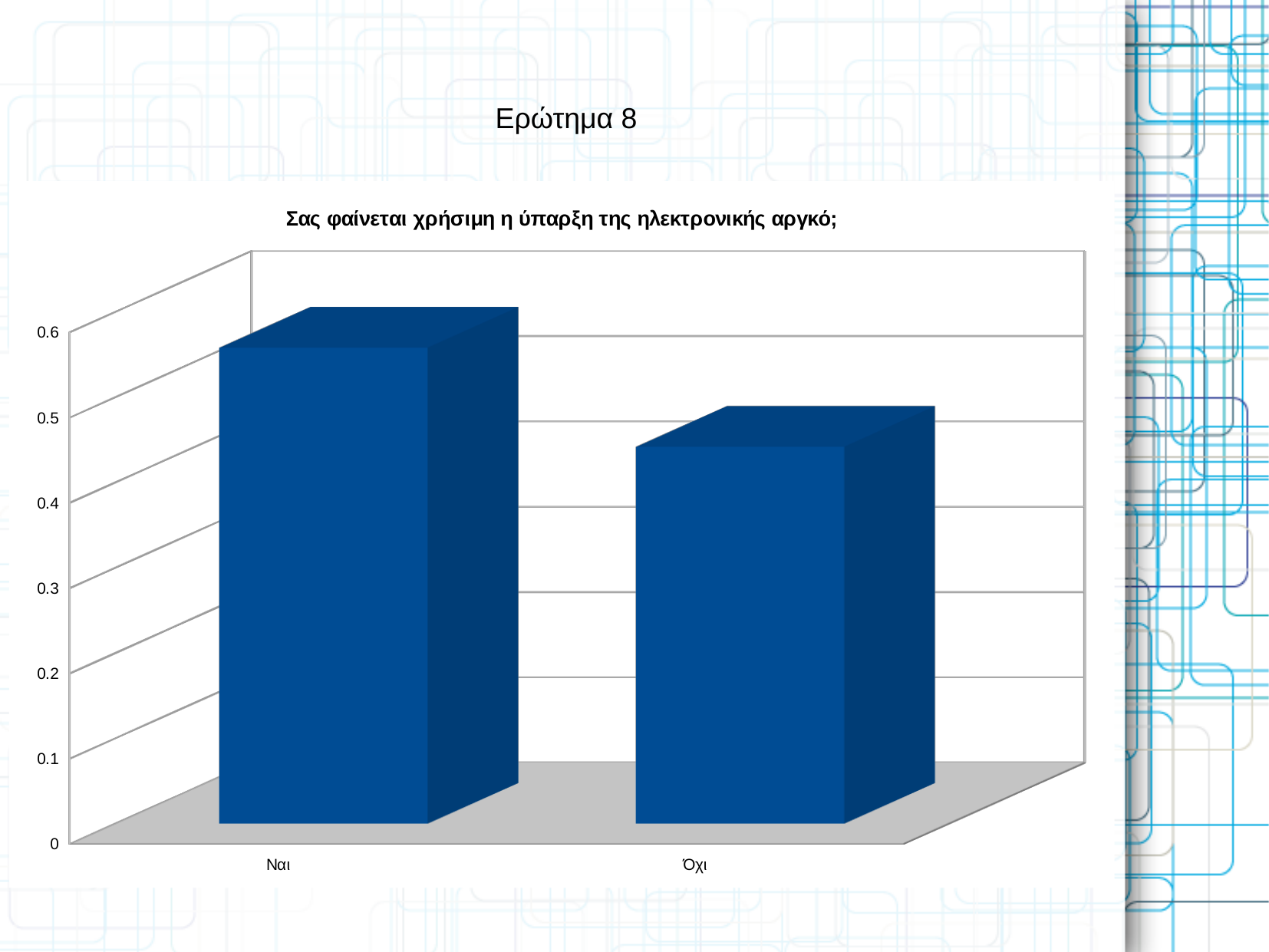
What is the title of the chart? Σας φαίνεται χρήσιμη η ύπαρξη της ηλεκτρονικής αργκό; What kind of chart is shown on the slide? bar chart What is the highest value shown on the vertical axis of the chart? 0.6 Is the value for Ναι greater or less than 0.5? greater Is the value for Όχι greater or less than 0.4? greater Is the value for Ναι greater or less than 0.6? less Which is larger, the value for Ναι or the value for Όχι? Ναι What colour are the bars in the chart? blue Which category has the highest bar in the chart? Ναι Which category has the lowest bar in the chart? Όχι How many categories are shown on the x axis of the chart? 2